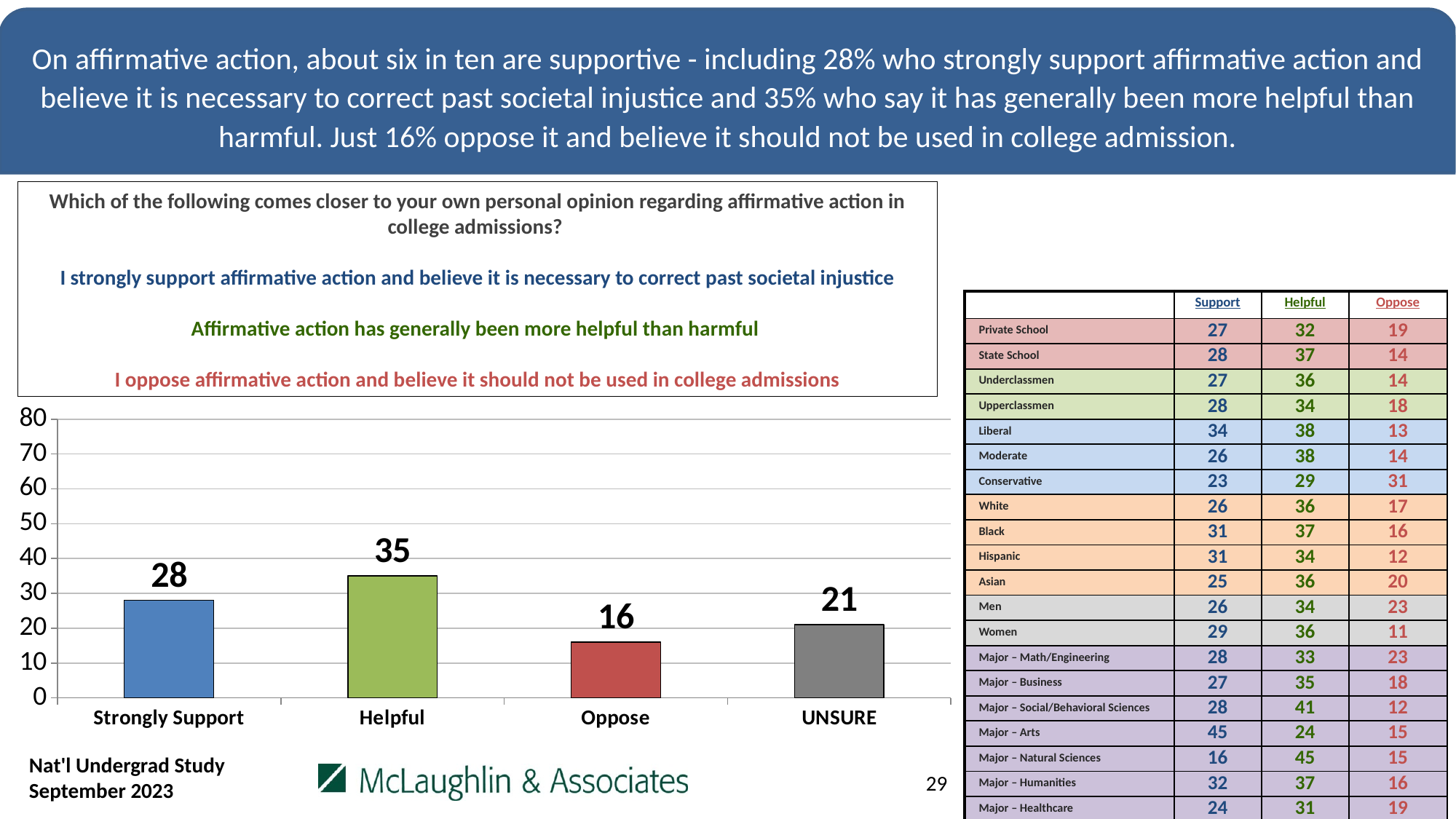
Which category has the lowest value in the bar chart? Oppose Is the value for Helpful in the bar chart greater or less than 30? greater What is the value for UNSURE in the bar chart? 21 What is the difference between the Helpful and Oppose values in the bar chart? 19 How many categories are shown in the bar chart? 4 What is the value for Helpful in the bar chart? 35 What is the highest value shown on the vertical axis of the bar chart? 80 Which is larger in the bar chart, Strongly Support or UNSURE? Strongly Support What kind of chart is shown on the slide? bar chart What is the value for Strongly Support in the bar chart? 28 Which category has the highest value in the bar chart? Helpful What is the value for Oppose in the bar chart? 16